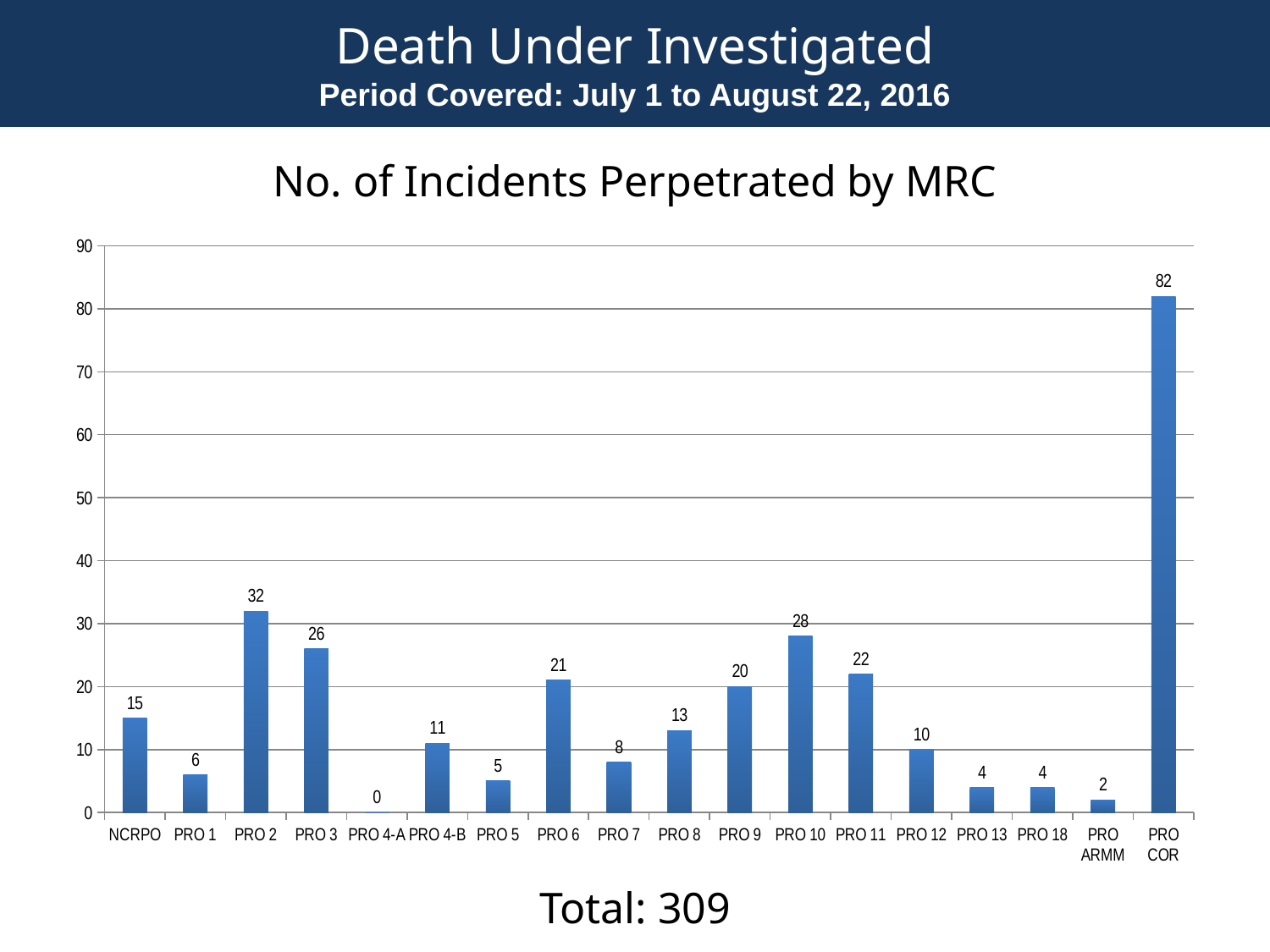
Which category has the highest number of incidents? PRO COR Which is larger, the value for PRO 6 or the value for PRO 11? PRO 11 Is the value for PRO 9 greater or less than 30? less What is the difference between the values for PRO 2 and PRO 3? 6 How many categories are shown on the x axis? 18 What is the number of incidents for PRO COR? 82 What kind of chart is shown on the slide? bar chart What is the number of incidents for PRO 10? 28 Which category has the lowest number of incidents? PRO 4-A What is the title of the chart? No. of Incidents Perpetrated by MRC What is the number of incidents for PRO 4-B? 11 What is the difference between the values for PRO COR and PRO 10? 54